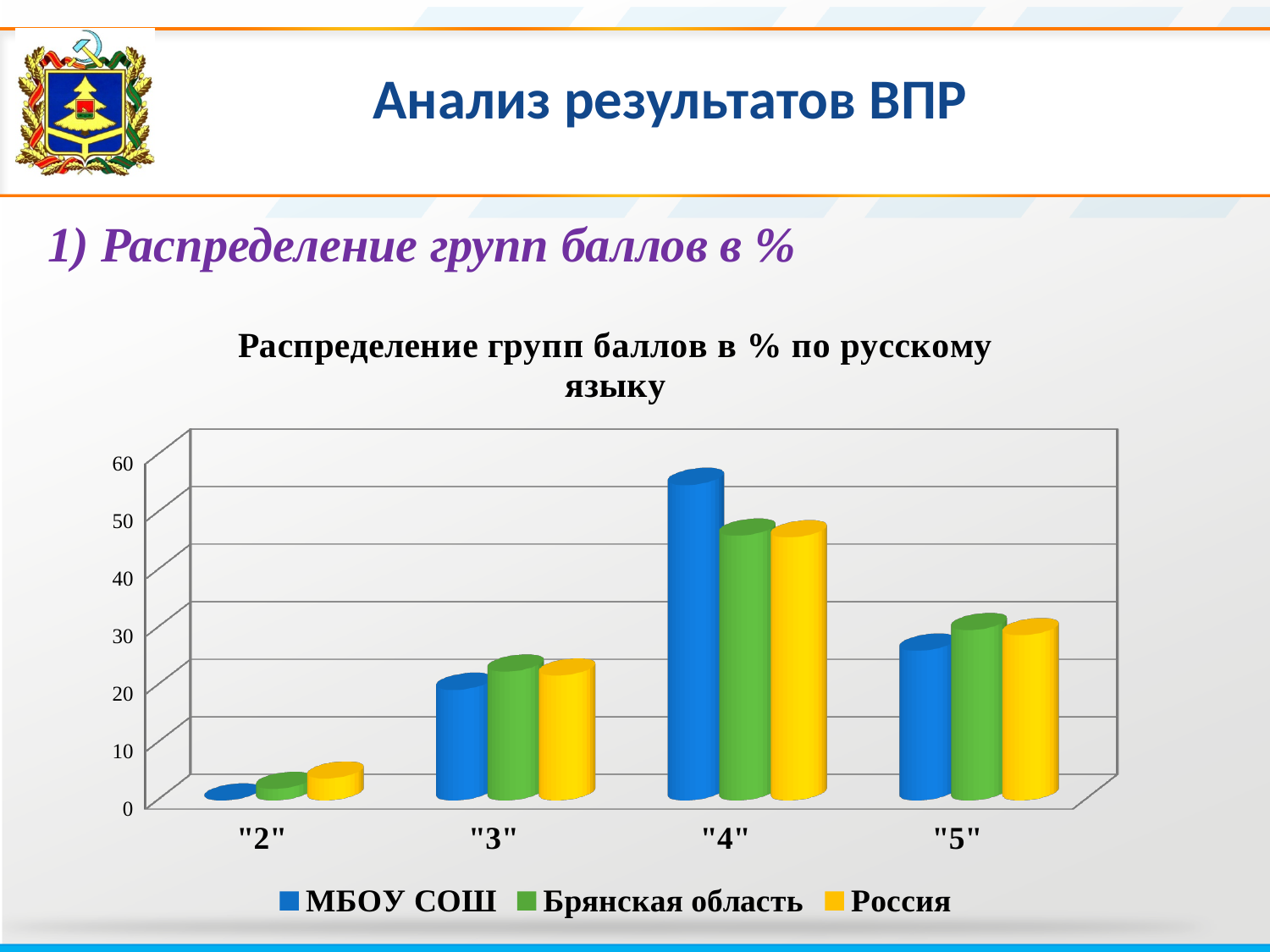
Is the МБОУ СОШ value for score group "4" greater or less than 50? greater What kind of chart is shown on the slide? bar chart Is the Брянская область value for score group "4" greater or less than 50? less How many series does the chart legend list? 3 For which score group is the Россия value lowest? "2" For score group "2", which is larger: the Россия value or the МБОУ СОШ value? Россия Which series is shown in blue in the chart? МБОУ СОШ What is the title of the chart? Распределение групп баллов в % по русскому языку For score group "4", which is larger: the МБОУ СОШ value or the Брянская область value? МБОУ СОШ For which score group is the МБОУ СОШ value highest? "4" How many score groups (categories) are shown on the x axis of the chart? 4 Is the Россия value for score group "2" greater or less than 10? less